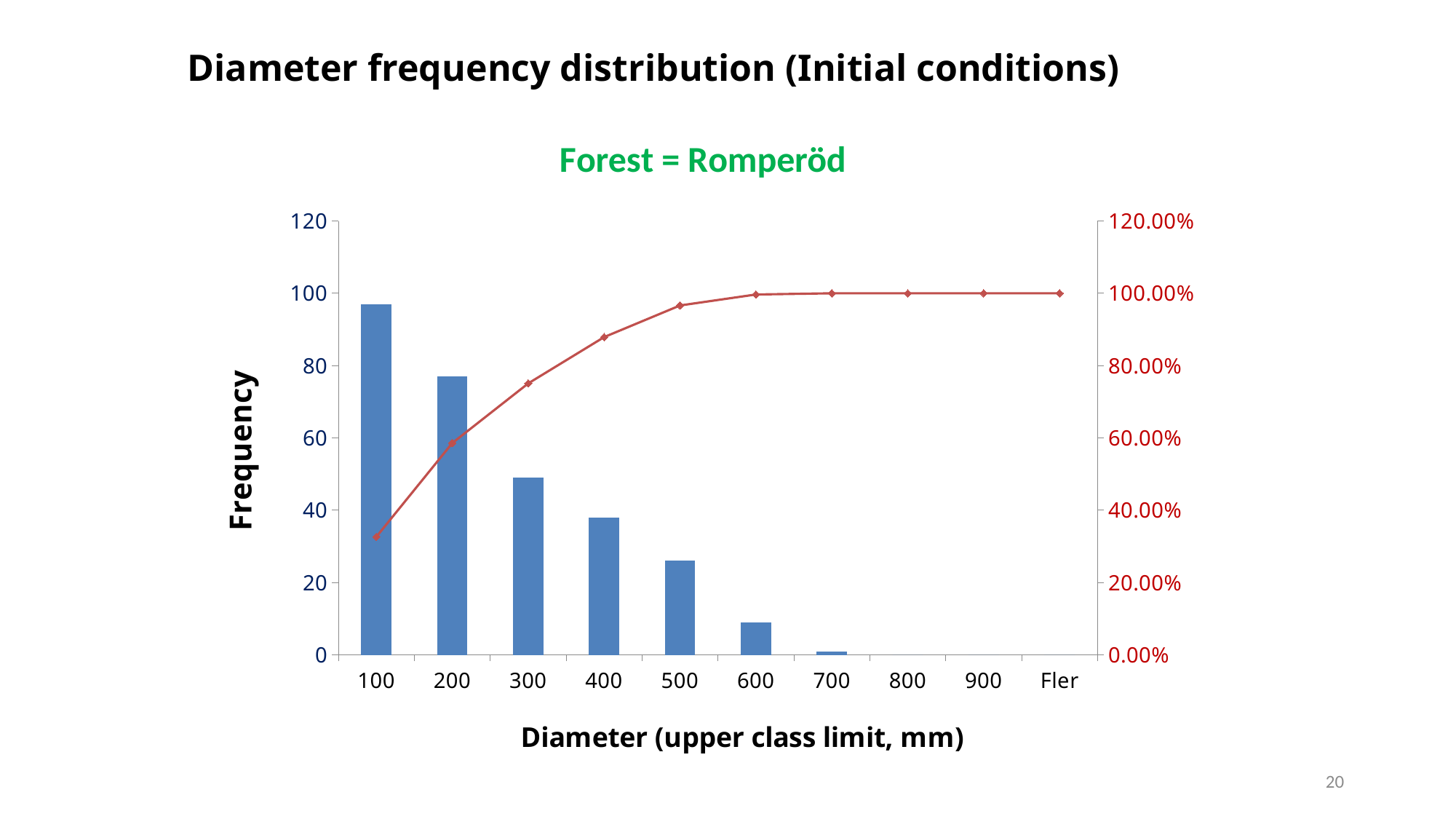
How many categories are shown on the x axis of the chart? 10 Which has a higher frequency, the 200 class or the 400 class? 200 Is the frequency for the 100 diameter class greater or less than 80? greater Which diameter class has the highest frequency? 100 Do the bar frequencies rise or fall as diameter increases along the x axis? fall Is the frequency for the 500 diameter class greater or less than 20? greater What kind of chart is shown on the slide? A combined bar and line chart What is the label of the x axis of the chart? Diameter (upper class limit, mm) What cumulative percentage does the line reach at the 900 diameter class? 100.00% Is the frequency for the 300 diameter class greater or less than 60? less